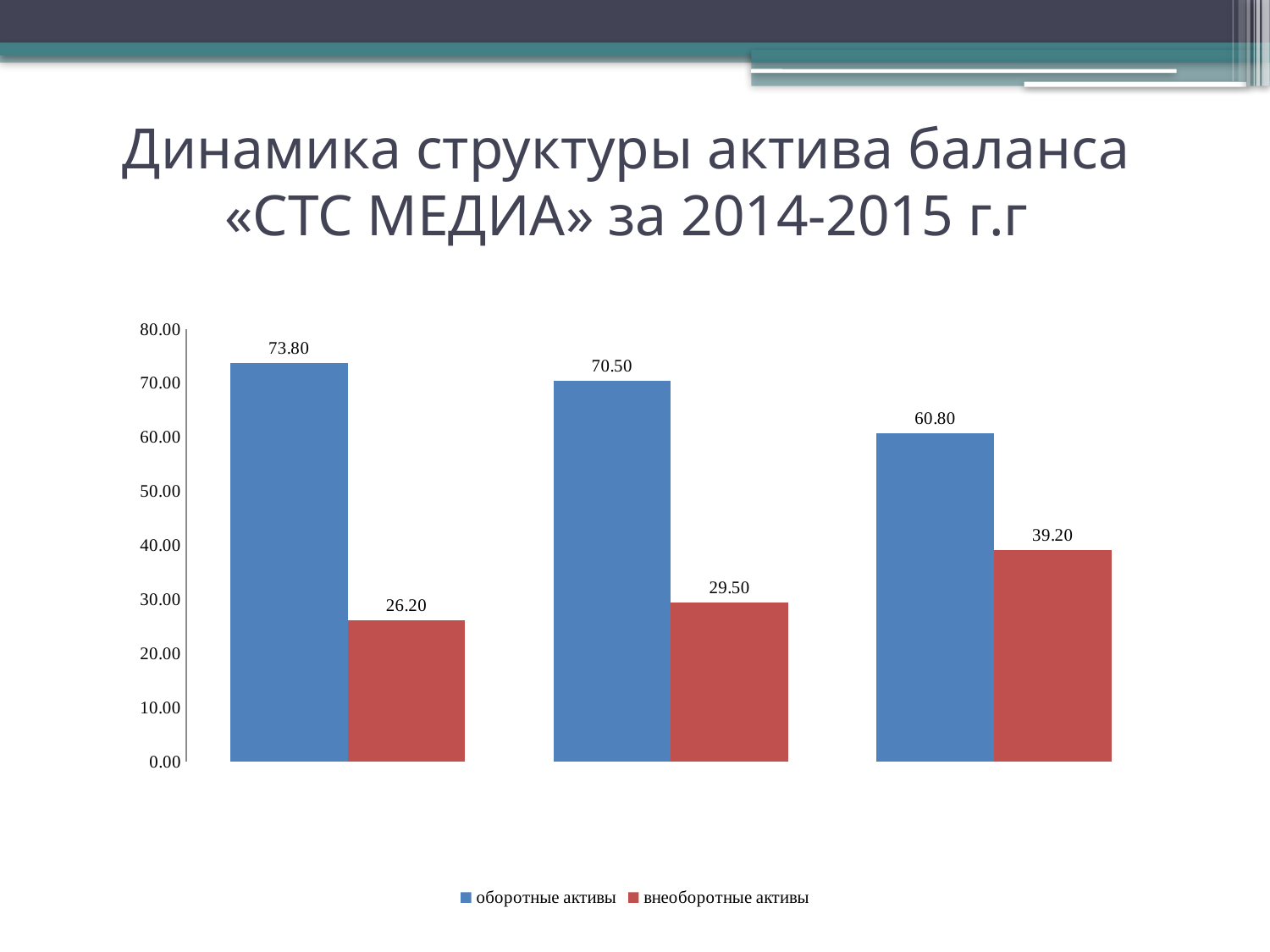
Which group of bars has the highest value for оборотные активы? the first (leftmost) group What is the value of внеоборотные активы in the third (rightmost) group of bars? 39.20 In the middle group of bars, which is larger: оборотные активы or внеоборотные активы? оборотные активы Which group of bars has the lowest value for внеоборотные активы? the first (leftmost) group Do the values for оборотные активы rise or fall from left to right across the groups? fall What kind of chart is shown on the slide? bar chart How many groups of bars are plotted in the chart? 3 What is the difference between оборотные активы and внеоборотные активы in the third (rightmost) group of bars? 21.60 What is the value of оборотные активы in the first (leftmost) group of bars? 73.80 Which colour represents внеоборотные активы in the chart? red How many series does the legend list? 2 What is the value of внеоборотные активы in the middle group of bars? 29.50